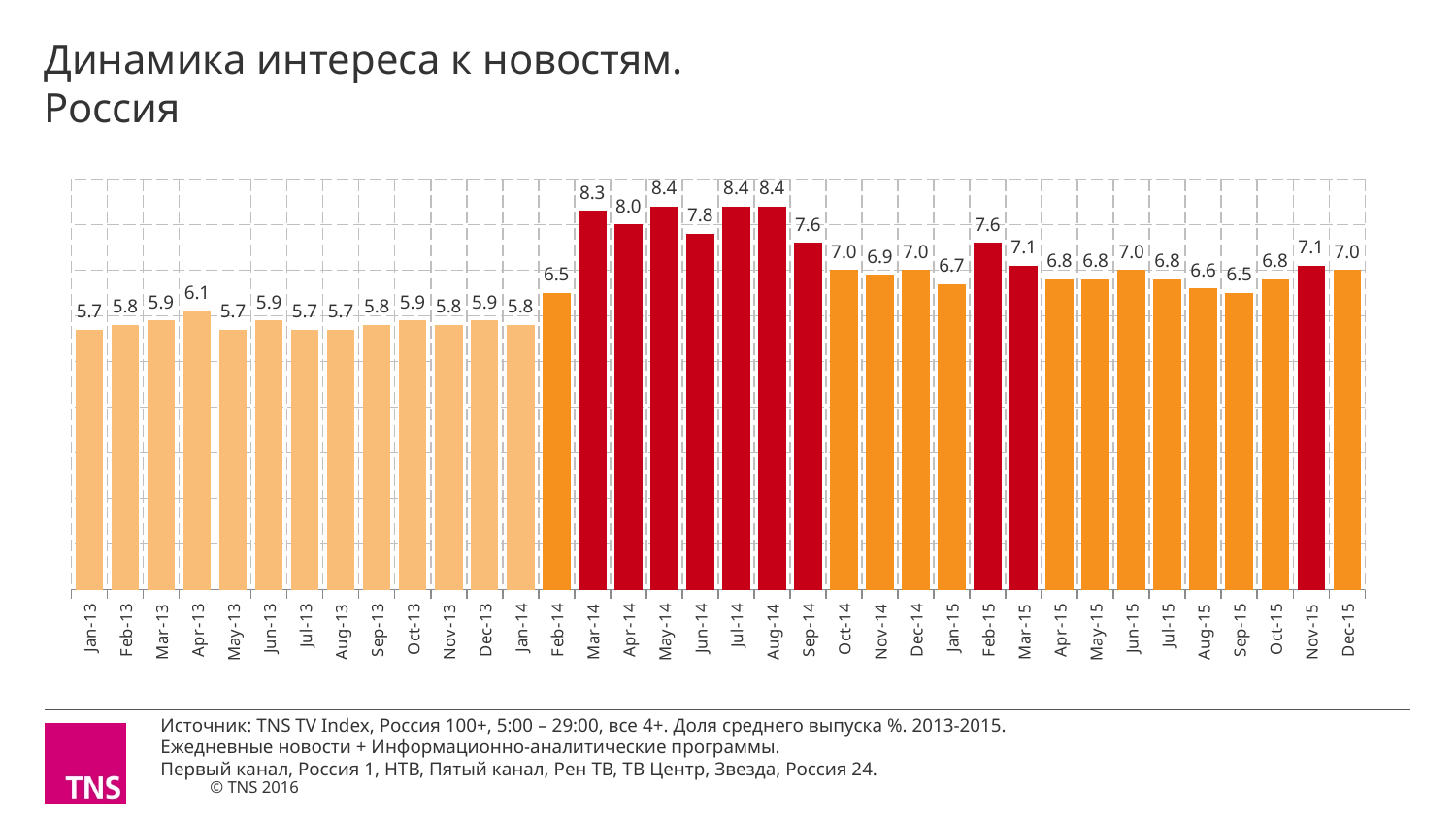
How many bars (months) are plotted on the chart? 36 What is the value for Jan-13? 5.7 Do the values rise or fall from Jan-14 to Mar-14? Rise What is the lowest value shown on the chart? 5.7 What is the highest value shown on the chart? 8.4 What kind of chart is shown on the slide? Bar chart What is the title of the chart? Динамика интереса к новостям. Россия Which is larger, the value for Jun-14 or the value for Sep-14? Jun-14 What is the value for Dec-15? 7.0 What is the value for Feb-15? 7.6 What is the difference between the values for Mar-14 and Feb-14? 1.8 What is the value for Apr-14? 8.0